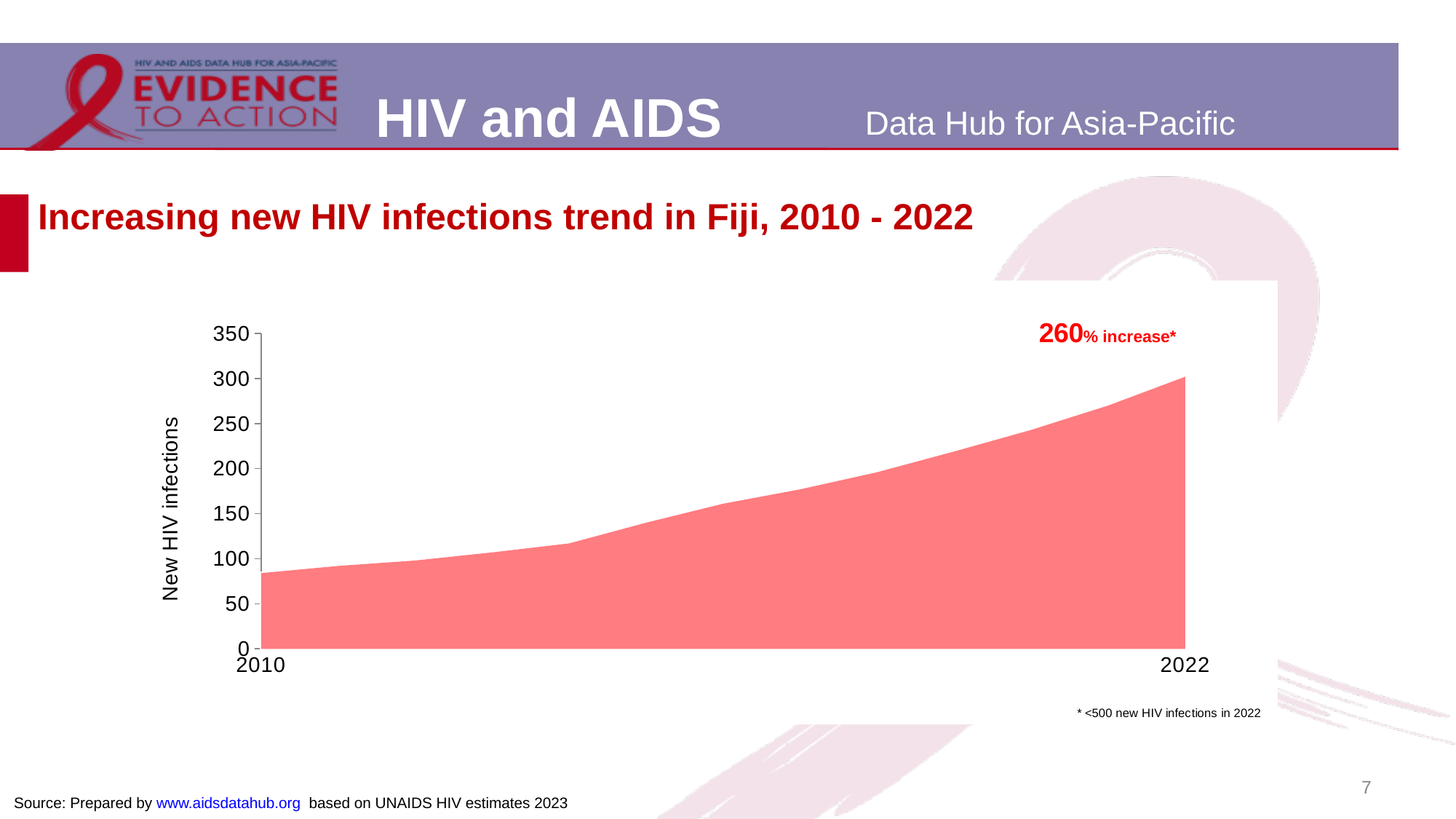
What is the label of the y axis? New HIV infections Is the value for new HIV infections in 2022 greater or less than 250? greater What is the highest value shown on the y axis? 350 Is the value for new HIV infections in 2010 greater or less than 50? greater What kind of chart is shown on the slide? area chart What percentage increase in new HIV infections is printed on the chart? 260% increase What is the title of the chart? Increasing new HIV infections trend in Fiji, 2010 - 2022 Which year has the higher number of new HIV infections, 2010 or 2022? 2022 Is the value for new HIV infections in 2010 greater or less than 100? less Do new HIV infections in Fiji rise or fall from 2010 to 2022? rise What are the first and last years shown on the x axis? 2010 and 2022